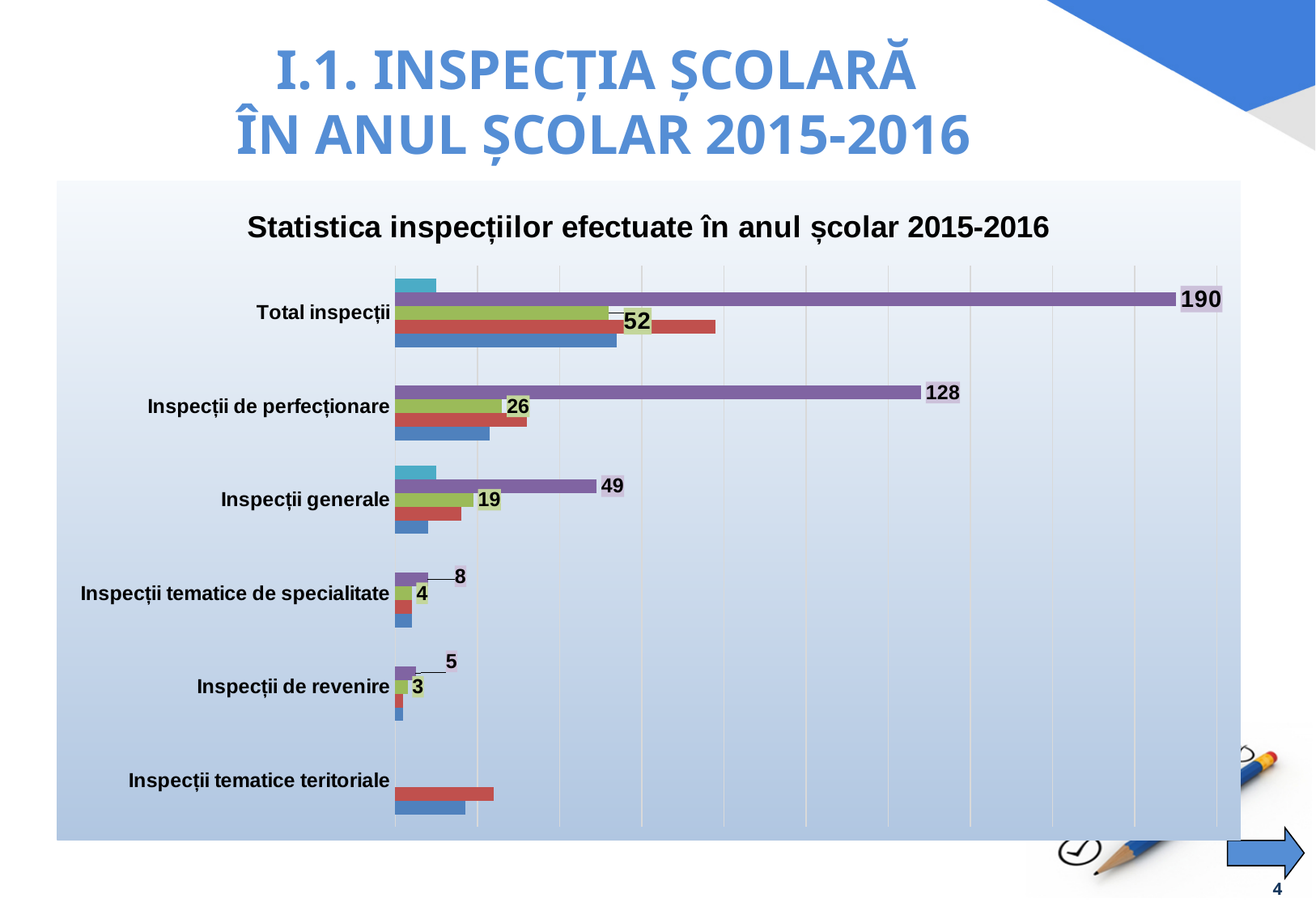
What is the value of the green bar for Inspecții de revenire? 3 What is the value of the green bar for Inspecții generale? 19 What is the value of the purple bar for Inspecții tematice de specialitate? 8 What kind of chart is shown on the slide? bar chart What is the value of the green bar for Total inspecții? 52 How many categories are shown on the chart? 6 What is the difference between the purple bar values for Total inspecții and Inspecții de perfecționare? 62 What is the title of the chart? Statistica inspecțiilor efectuate în anul școlar 2015-2016 Which category has the highest purple bar value? Total inspecții Which is larger: the purple bar for Inspecții generale or the green bar for Inspecții de perfecționare? the purple bar for Inspecții generale What is the value of the purple bar for Inspecții de perfecționare? 128 What is the value of the purple bar for Total inspecții? 190